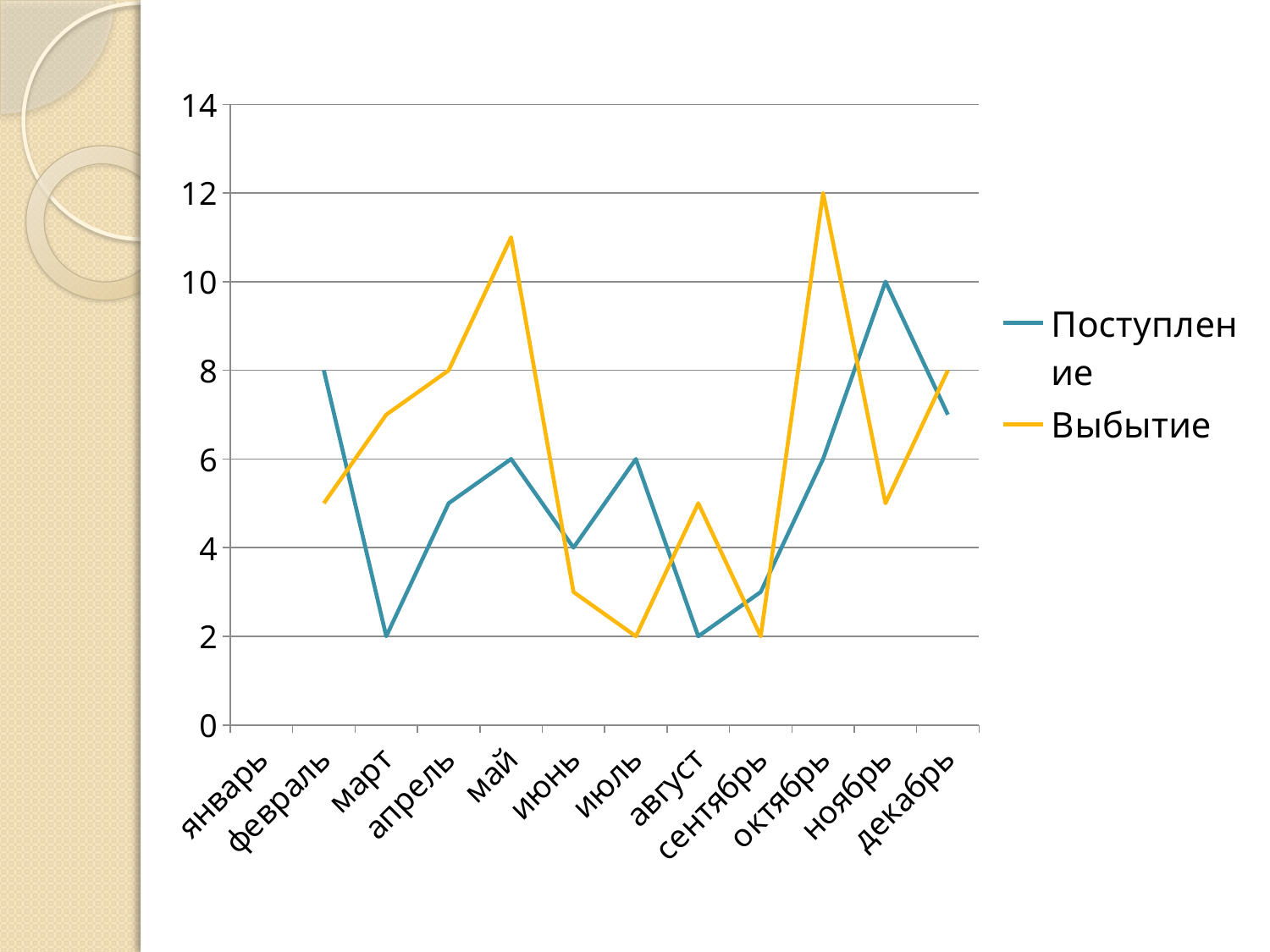
What is the value of Поступление in март? 2 What is the value of Поступление in ноябрь? 10 Does the Поступление line rise or fall from февраль to март? Fall How many month categories are shown on the x axis? 12 In which month does Поступление reach its highest value? ноябрь What is the difference between Выбытие and Поступление in октябрь? 6 How many series does the legend list? 2 In which month does Выбытие reach its highest value? октябрь Is the value of Выбытие in май greater or less than 10? greater What type of chart is shown on the slide? Line chart In октябрь, which series has the larger value, Поступление or Выбытие? Выбытие What is the value of Выбытие in октябрь? 12